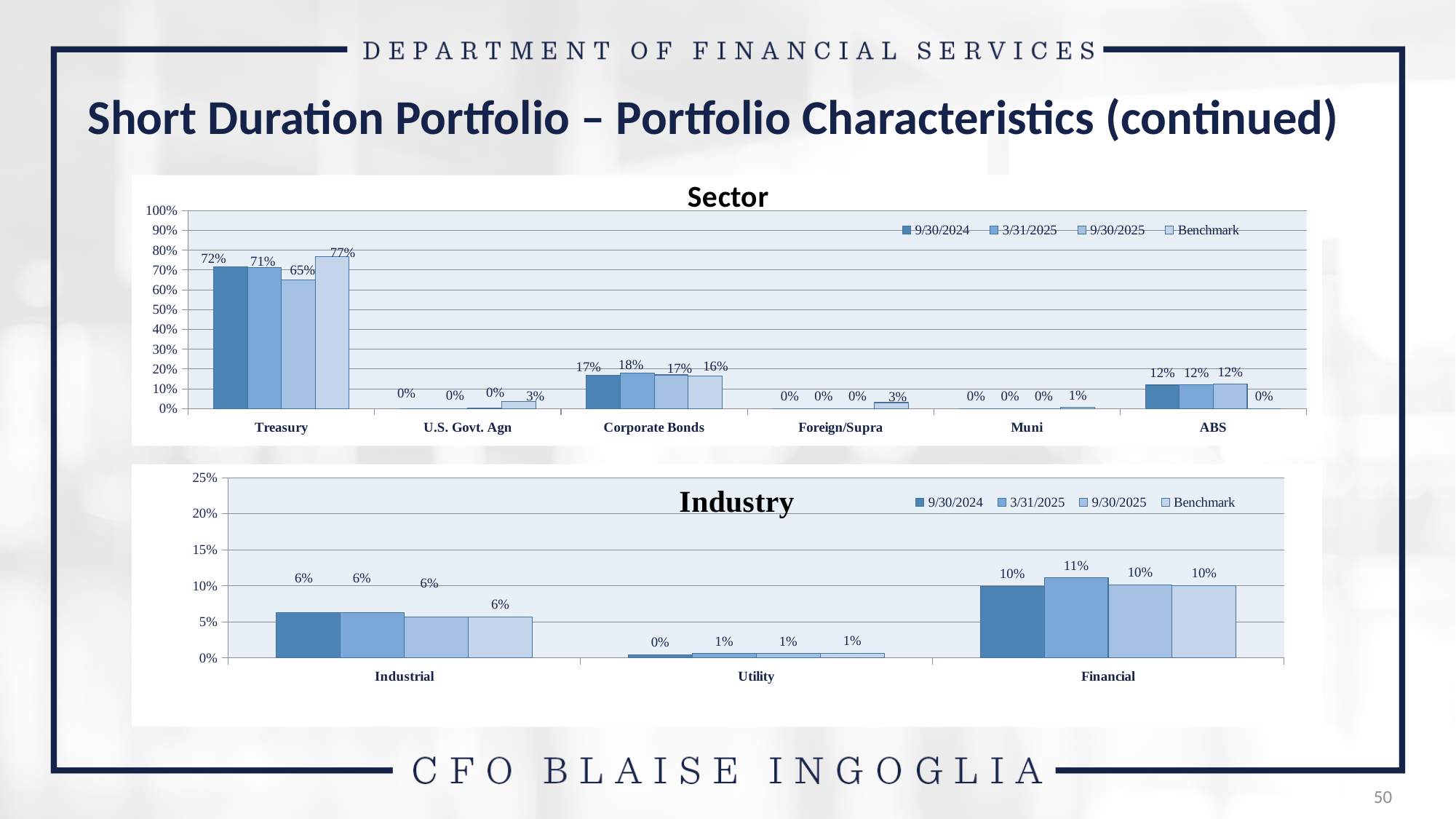
In the Sector chart, what is the 9/30/2025 value for Treasury? 65% In the Industry chart, which category has the lowest 9/30/2024 value? Utility In the Sector chart, what is the Benchmark value for Treasury? 77% In the Sector chart, which category has the highest 9/30/2024 value? Treasury In the Industry chart, is the 9/30/2024 value for Financial larger or smaller than the 9/30/2024 value for Industrial? larger In the Sector chart, how many categories are shown on the x axis? 6 In the Sector chart, how many series does the legend list? 4 What kind of chart is the Industry chart? bar chart In the Sector chart, what is the Benchmark value for ABS? 0% In the Sector chart, what is the difference between the Benchmark and 9/30/2025 values for Treasury? 12% In the Sector chart, what is the 3/31/2025 value for Corporate Bonds? 18% In the Industry chart, what is the 3/31/2025 value for Financial? 11%